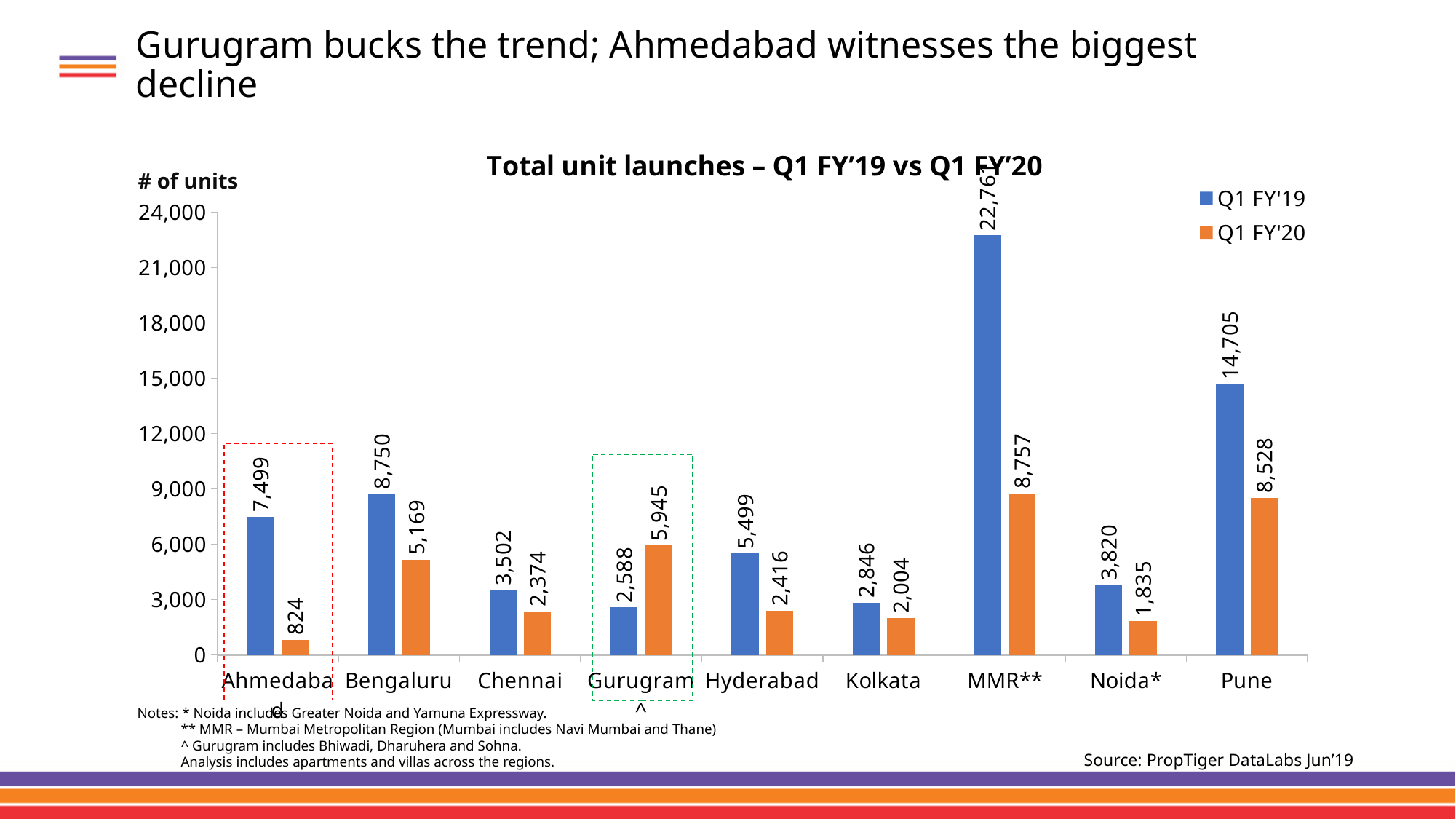
What is the difference between the Q1 FY'19 and Q1 FY'20 values for Hyderabad? 3,083 What is the difference between the Q1 FY'19 and Q1 FY'20 values for Bengaluru? 3,581 How many cities are shown on the x axis? 9 How many series does the legend list? 2 What is the Q1 FY'20 value for Pune? 8,528 Is the Q1 FY'19 value for Pune greater or less than 12,000? greater For Gurugram, which series has the larger value, Q1 FY'19 or Q1 FY'20? Q1 FY'20 What is the Q1 FY'19 value for Gurugram? 2,588 Which city has the highest Q1 FY'19 value? MMR** What is the Q1 FY'20 value for Ahmedabad? 824 What kind of chart is shown on the slide? bar chart Which city has the lowest Q1 FY'20 value? Ahmedabad